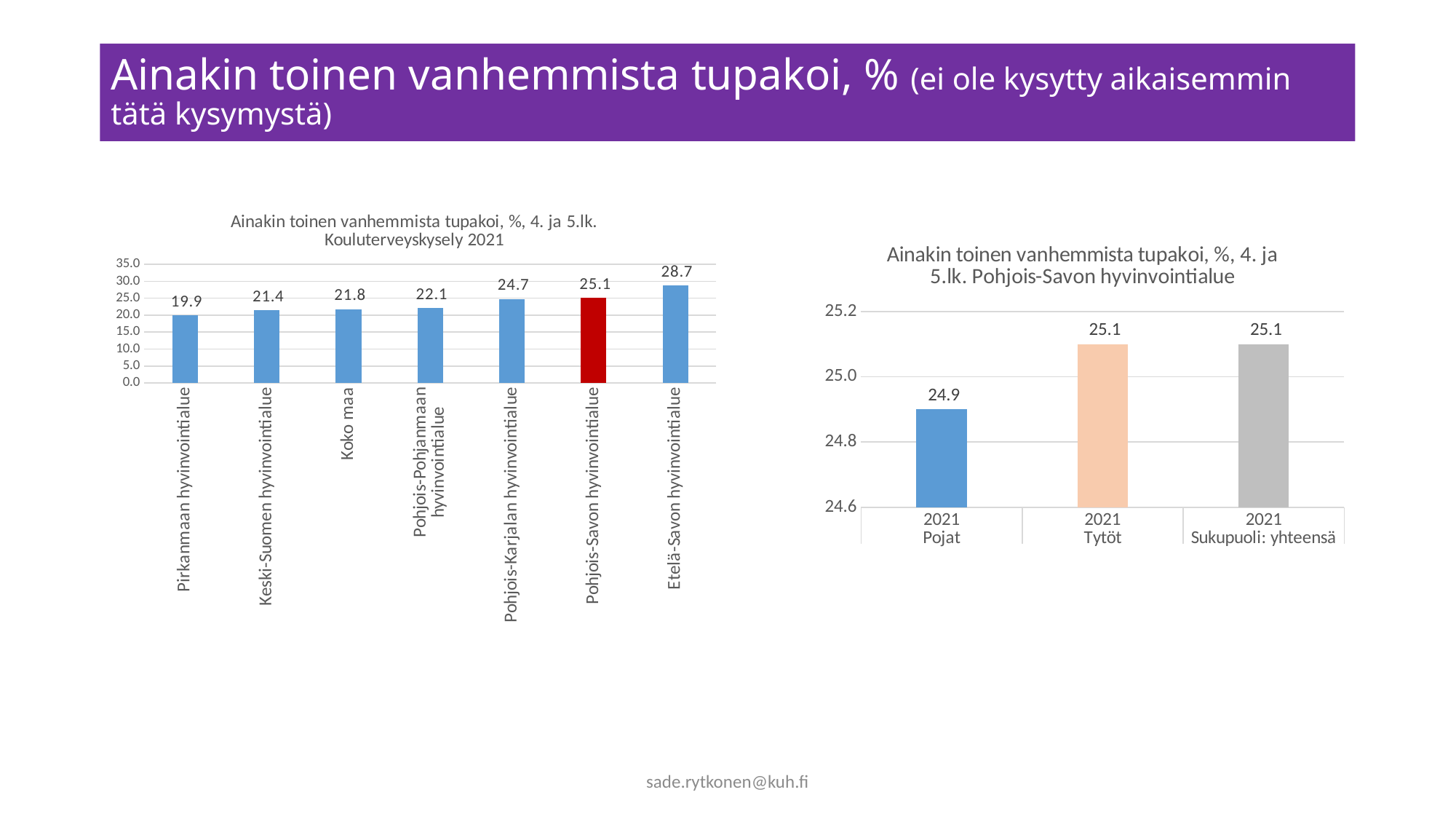
In the right chart (Pohjois-Savon hyvinvointialue), what is the value for 2021 Pojat? 24.9 In the left chart (Kouluterveyskysely 2021), which category has the highest value? Etelä-Savon hyvinvointialue In the left chart (Kouluterveyskysely 2021), what is the value for Koko maa? 21.8 In the left chart (Kouluterveyskysely 2021), what is the difference between Etelä-Savon hyvinvointialue and Pirkanmaan hyvinvointialue? 8.8 In the left chart (Kouluterveyskysely 2021), how many categories are shown? 7 In the left chart (Kouluterveyskysely 2021), which category has the lowest value? Pirkanmaan hyvinvointialue What kind of chart is the right chart (Pohjois-Savon hyvinvointialue)? Bar chart In the right chart (Pohjois-Savon hyvinvointialue), what is the difference between Tytöt and Pojat? 0.2 In the right chart (Pohjois-Savon hyvinvointialue), what is the value for 2021 Tytöt? 25.1 In the left chart (Kouluterveyskysely 2021), which bar is coloured red? Pohjois-Savon hyvinvointialue In the left chart (Kouluterveyskysely 2021), what is the value for Pohjois-Savon hyvinvointialue? 25.1 In the left chart (Kouluterveyskysely 2021), which is larger: Keski-Suomen hyvinvointialue or Pohjois-Karjalan hyvinvointialue? Pohjois-Karjalan hyvinvointialue